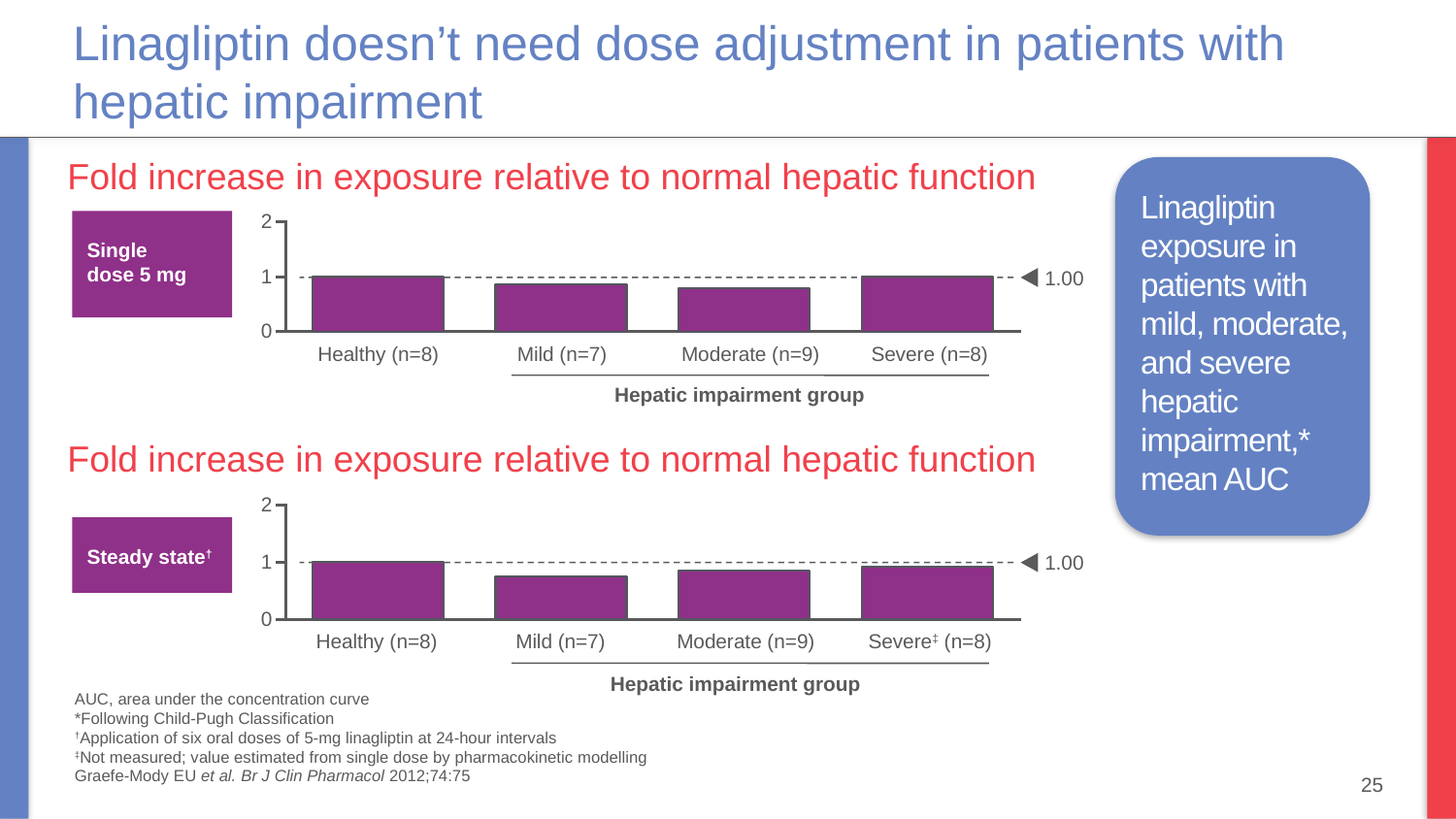
In the bottom chart (Steady state), what is the fold increase in exposure for the Healthy (n=8) group? 1.00 In the bottom chart (Steady state), which group has the highest fold increase in exposure? Healthy (n=8) In the bottom chart (Steady state), is the value for Severe (n=8) greater or less than 2? less In the top chart (Single dose 5 mg), is the value for Moderate (n=9) greater or less than 1? less In the top chart (Single dose 5 mg), which is larger, the value for Mild (n=7) or Moderate (n=9)? Mild (n=7) In the bottom chart (Steady state), is the value for Mild (n=7) greater or less than 1? less What kind of chart is the top chart (Single dose 5 mg)? bar chart How many hepatic impairment groups are shown on the x axis of the bottom chart (Steady state)? 4 In the bottom chart (Steady state), which is larger, the value for Mild (n=7) or Moderate (n=9)? Moderate (n=9) What is the x-axis title of the top chart (Single dose 5 mg)? Hepatic impairment group In the bottom chart (Steady state), which group has the lowest fold increase in exposure? Mild (n=7) In the top chart (Single dose 5 mg), what is the fold increase in exposure for the Healthy (n=8) group? 1.00